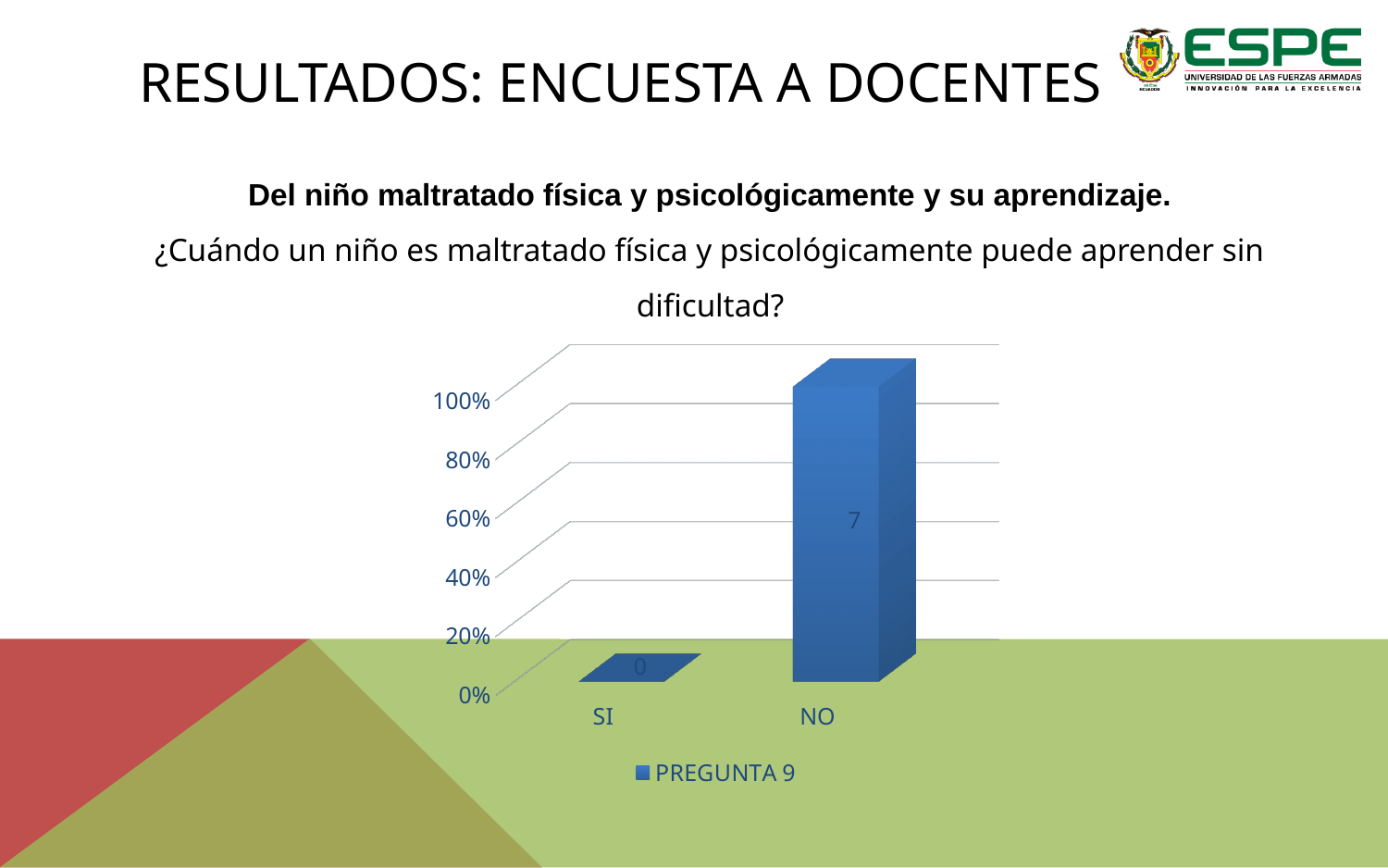
What is the difference between the data labels for NO and SI? 7 What is the legend entry for the series in the chart? PREGUNTA 9 How many categories are shown on the x axis? 2 Which category has the highest bar? NO Is the value for SI greater or less than 20%? less What data label is shown on the bar for NO? 7 How many series does the legend list? 1 Is the value for NO greater or less than 80%? greater Which bar is taller, SI or NO? NO What kind of chart is shown on the slide? bar chart What data label is shown on the bar for SI? 0 Which category has the lowest bar? SI